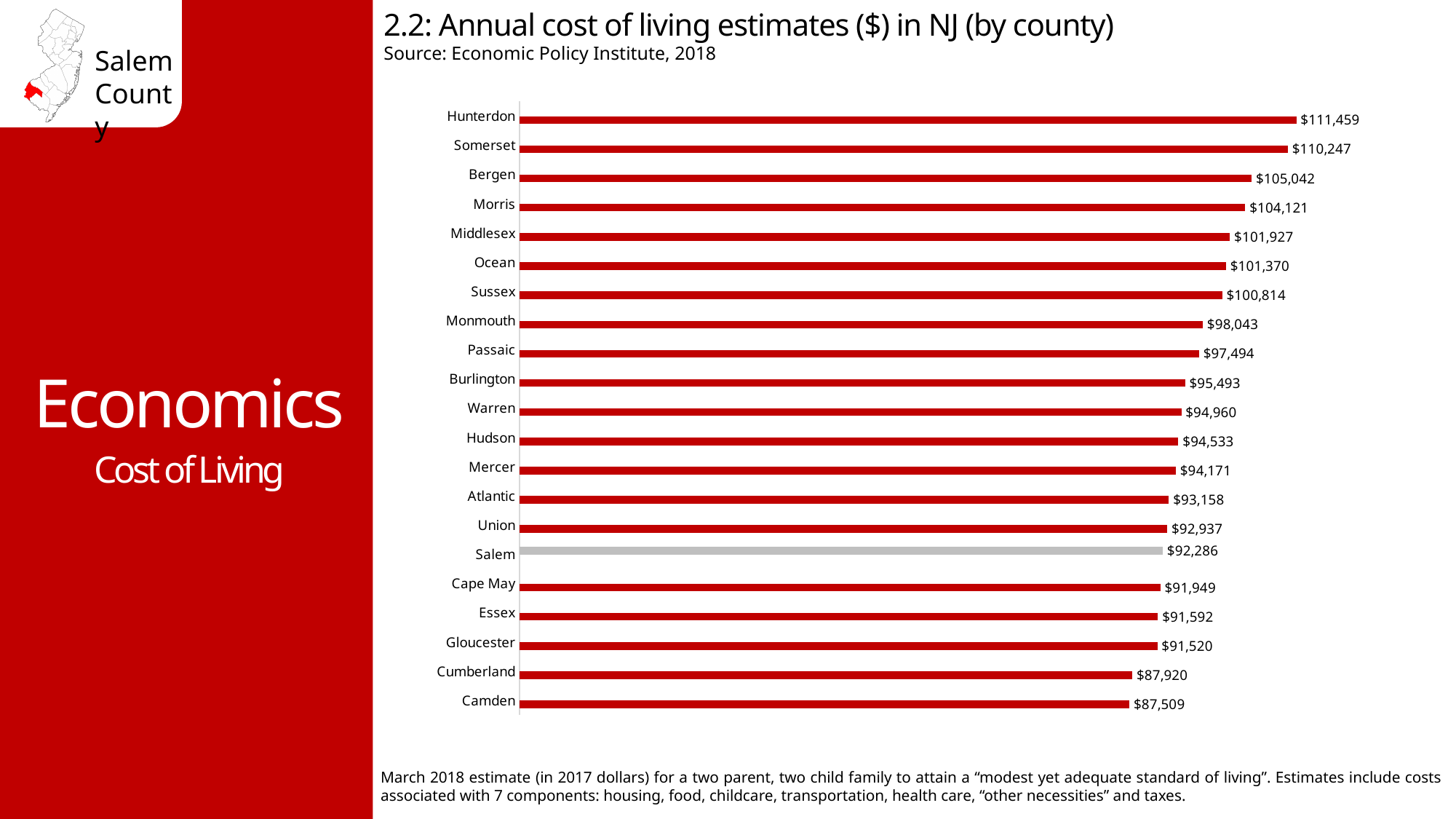
What is the annual cost of living estimate for Cumberland County? $87,920 What is the difference between the cost of living estimates for Salem and Camden? $4,777 Which county has a higher cost of living estimate, Morris or Middlesex? Morris What is the annual cost of living estimate for Salem County? $92,286 What is the annual cost of living estimate for Bergen County? $105,042 Which county has the lowest annual cost of living estimate? Camden How many counties are shown in the chart? 21 Which county's bar is coloured grey instead of red? Salem What type of chart is shown on the slide? Bar chart Which county has a higher cost of living estimate, Gloucester or Cumberland? Gloucester What is the difference between the cost of living estimates for Hunterdon and Camden? $23,950 Which county has the highest annual cost of living estimate? Hunterdon